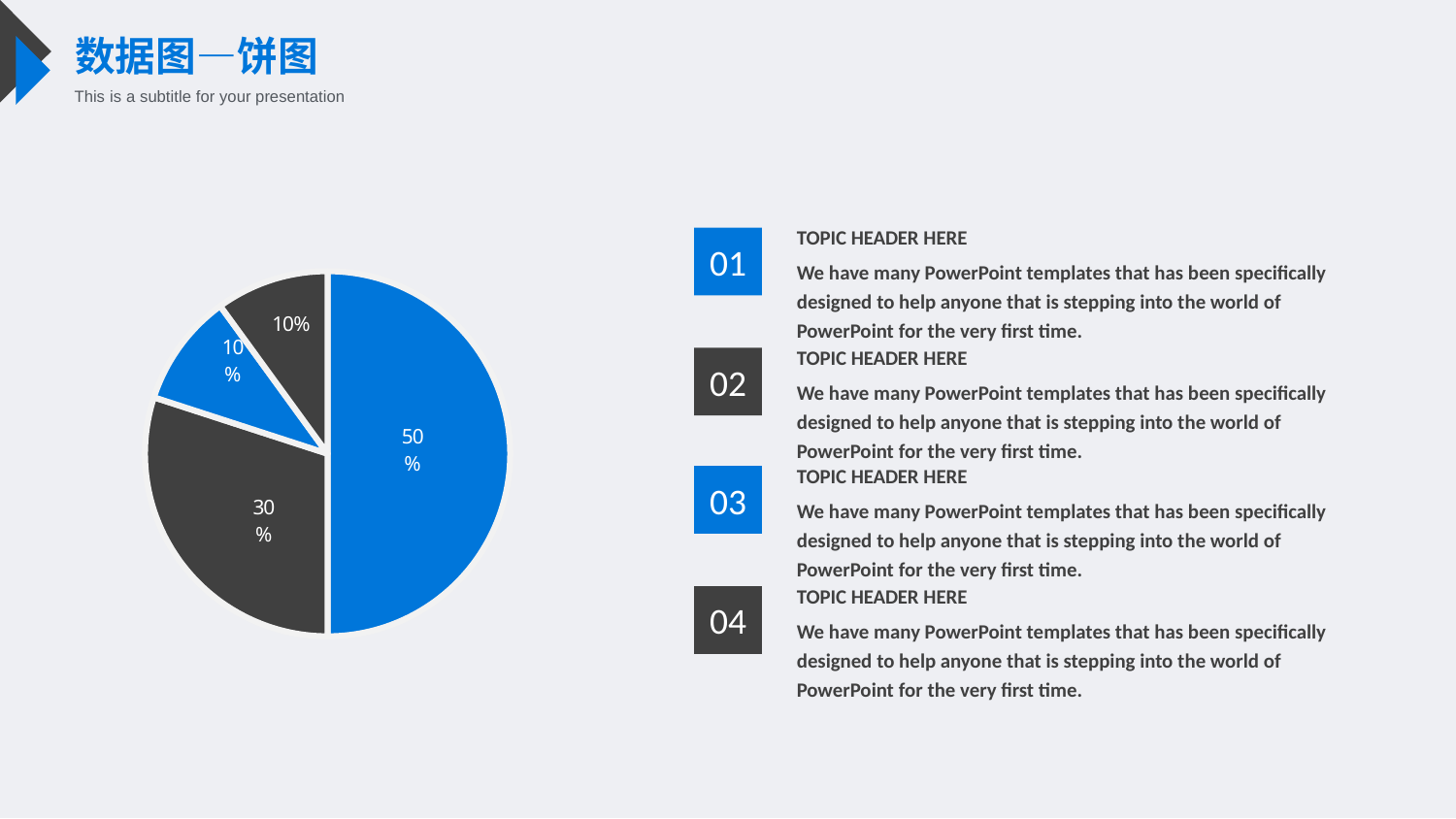
What is the value of the smallest slices of the pie chart? 10% What is the difference between the 50% slice and the 30% slice? 20% How many slices of the pie chart are labelled 10%? 2 What is the value of the largest slice of the pie chart? 50% What is the title of the slide containing the pie chart? 数据图—饼图 What share of the pie does the largest slice represent? 50% How many slices does the pie chart have? 4 What value is shown on the large dark gray slice at the lower left of the pie chart? 30% What value is shown on the large blue slice on the right side of the pie chart? 50% What kind of chart is shown on the slide? pie chart What is the total of all the slice values shown on the pie chart? 100% Which is larger, the large blue slice or the large dark gray slice? the large blue slice